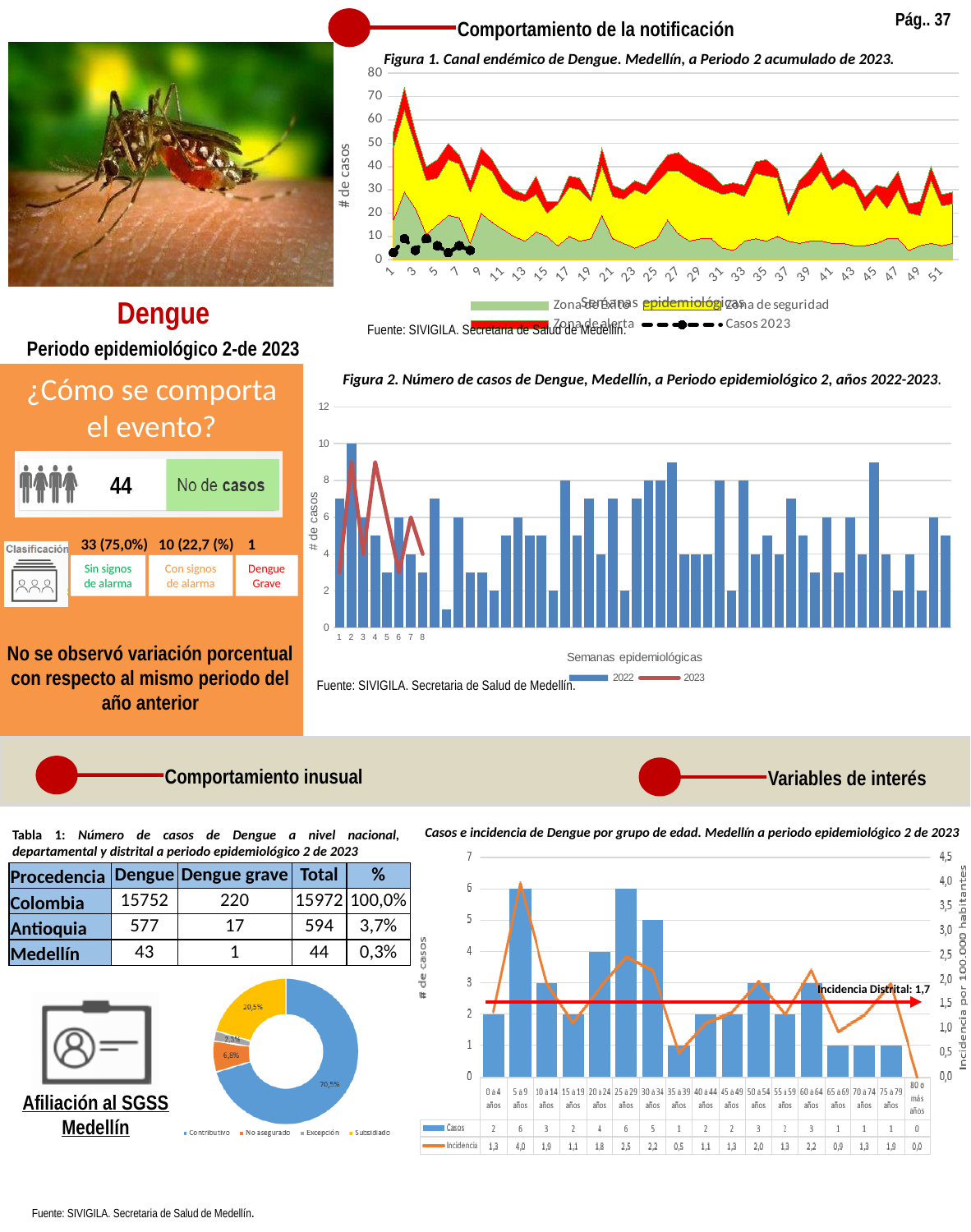
In the donut chart 'Afiliación al SGSS Medellín', what share does Contributivo represent? 70,5% In Figura 2 (Número de casos de Dengue, Medellín, años 2022-2023), how many series does the legend list? 2 In the donut chart 'Afiliación al SGSS Medellín', what share does Subsidiado represent? 20,5% In the chart 'Casos e incidencia de Dengue por grupo de edad', what is the Incidencia value for the 25 a 29 años age group? 2,5 In the chart 'Casos e incidencia de Dengue por grupo de edad', how many cases (Casos) are reported for the 5 a 9 años age group? 6 In the donut chart 'Afiliación al SGSS Medellín', which category has the smallest share? Excepción In Figura 2 (Número de casos de Dengue, Medellín, años 2022-2023), is the 2022 value for week 2 greater or less than 8? greater In the chart 'Casos e incidencia de Dengue por grupo de edad', which age group has the lowest number of Casos? 80 o más años In the chart 'Casos e incidencia de Dengue por grupo de edad', what is the difference in Casos between the 25 a 29 años group and the 35 a 39 años group? 5 In the chart 'Casos e incidencia de Dengue por grupo de edad', what value is given for the Incidencia Distrital? 1,7 In the chart 'Casos e incidencia de Dengue por grupo de edad', how many age groups are shown on the x axis? 17 In the chart 'Casos e incidencia de Dengue por grupo de edad', which age group has the highest Incidencia? 5 a 9 años